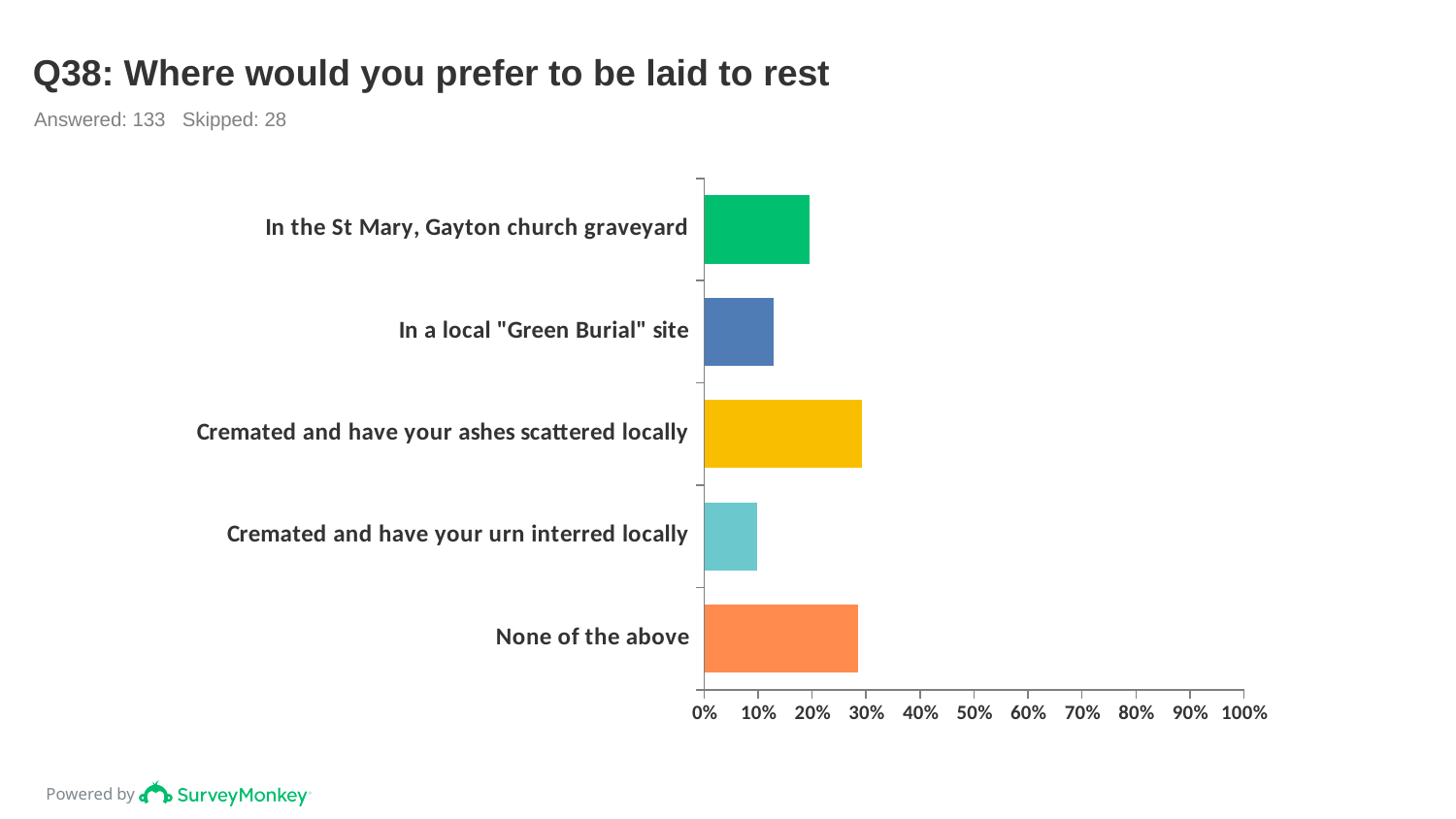
How many respondents answered the question according to the slide? 133 Is the value for "Cremated and have your urn interred locally" greater or less than 20%? less Is the value for "Cremated and have your ashes scattered locally" greater or less than 20%? greater Is the value for "In a local "Green Burial" site" greater or less than 20%? less Which category has the lowest value? Cremated and have your urn interred locally Which is larger: the value for "Cremated and have your ashes scattered locally" or for "Cremated and have your urn interred locally"? Cremated and have your ashes scattered locally What kind of chart is shown on the slide? bar chart What is the title of the chart? Q38: Where would you prefer to be laid to rest How many categories are shown in the chart? 5 Which is larger: the value for "In the St Mary, Gayton church graveyard" or for "In a local "Green Burial" site"? In the St Mary, Gayton church graveyard